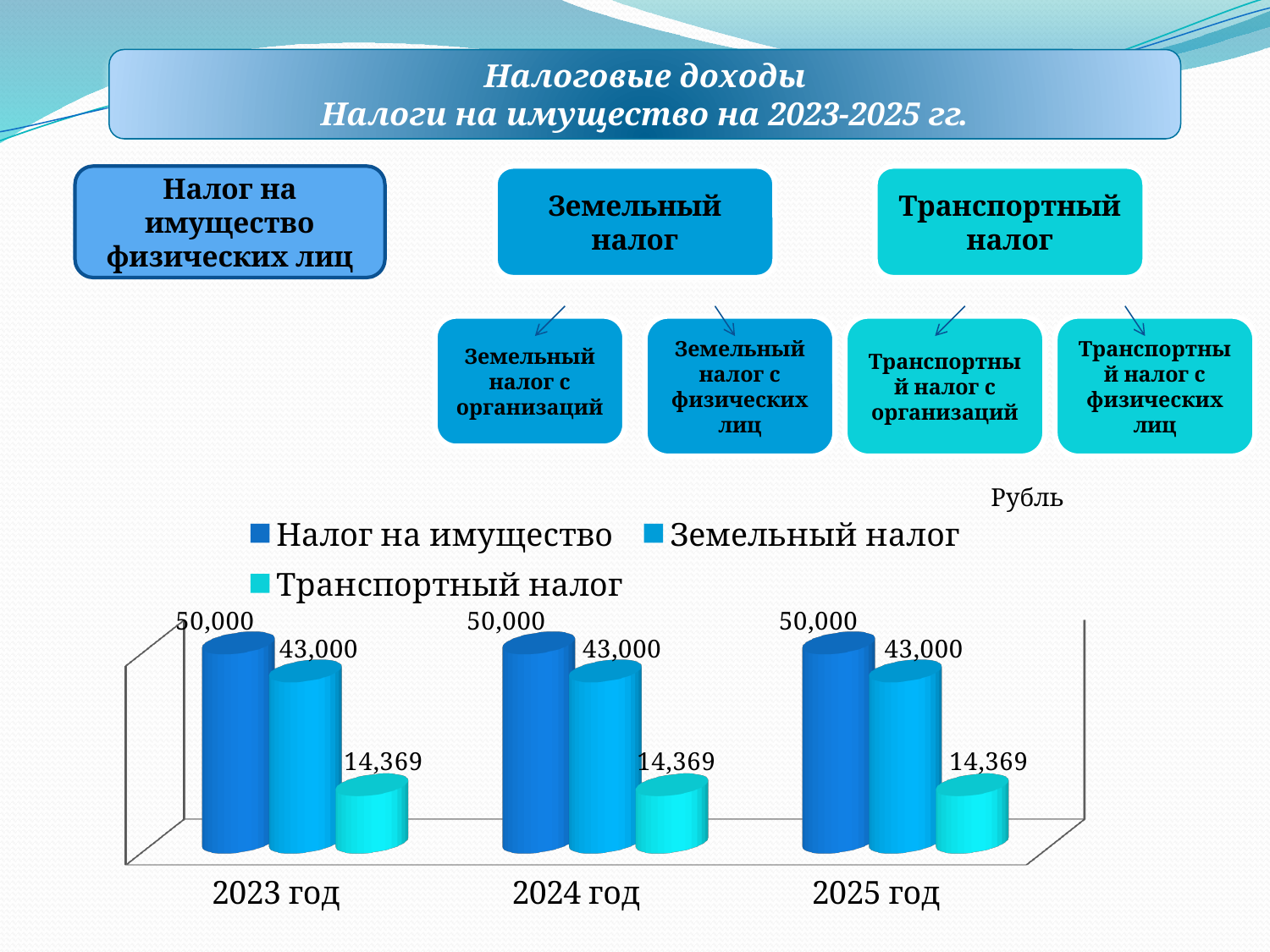
What is the value for Транспортный налог in 2025 год? 14,369 How many series does the legend list? 3 Does the value for Налог на имущество rise, fall or stay the same from 2023 год to 2025 год? stays the same What is the value for Налог на имущество in 2023 год? 50,000 Which series has the highest value in 2025 год? Налог на имущество Which is larger in 2024 год: Земельный налог or Транспортный налог? Земельный налог How many year categories are shown on the x axis? 3 What is the difference between Земельный налог and Транспортный налог in 2025 год? 28,631 What is the value for Земельный налог in 2024 год? 43,000 What kind of chart is shown on the slide? bar chart What is the difference between Налог на имущество and Земельный налог in 2023 год? 7,000 Which series has the lowest value in 2024 год? Транспортный налог